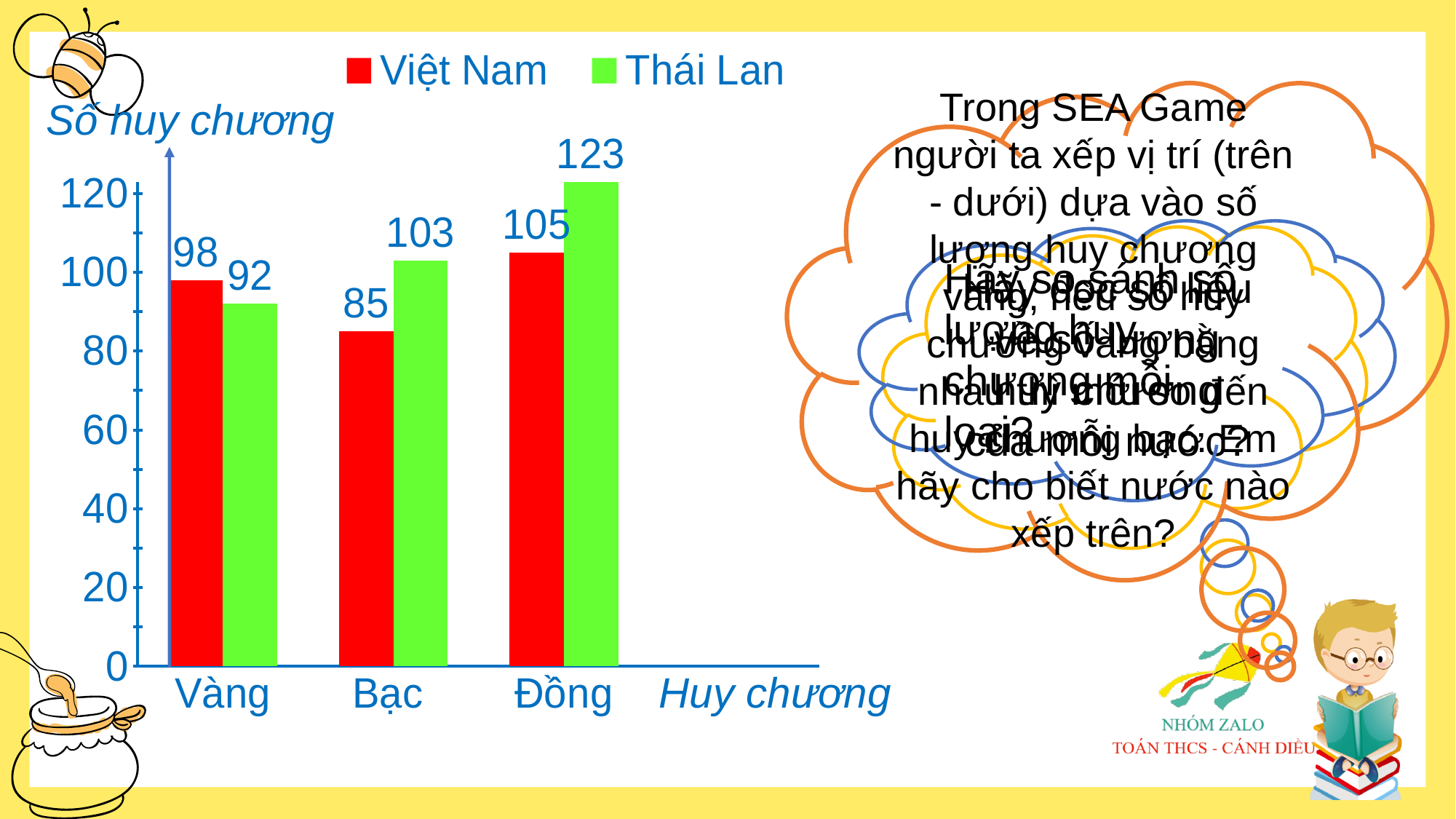
Which category has the highest value for Thái Lan? Đồng What is the difference between Thái Lan's and Việt Nam's values in the Bạc category? 18 How many gold (Vàng) medals does the chart show for Việt Nam? 98 Is the value for Thái Lan in the Đồng category greater or less than 120? greater What kind of chart is shown on the slide? bar chart What colour represents Thái Lan in the chart? green Which category has the lowest value for Việt Nam? Bạc How many series does the legend list? 2 How many medal categories are shown on the x axis? 3 What is the value for Thái Lan in the Đồng category? 123 In the Vàng category, which country has the larger value, Việt Nam or Thái Lan? Việt Nam What is the value for Việt Nam in the Bạc category? 85